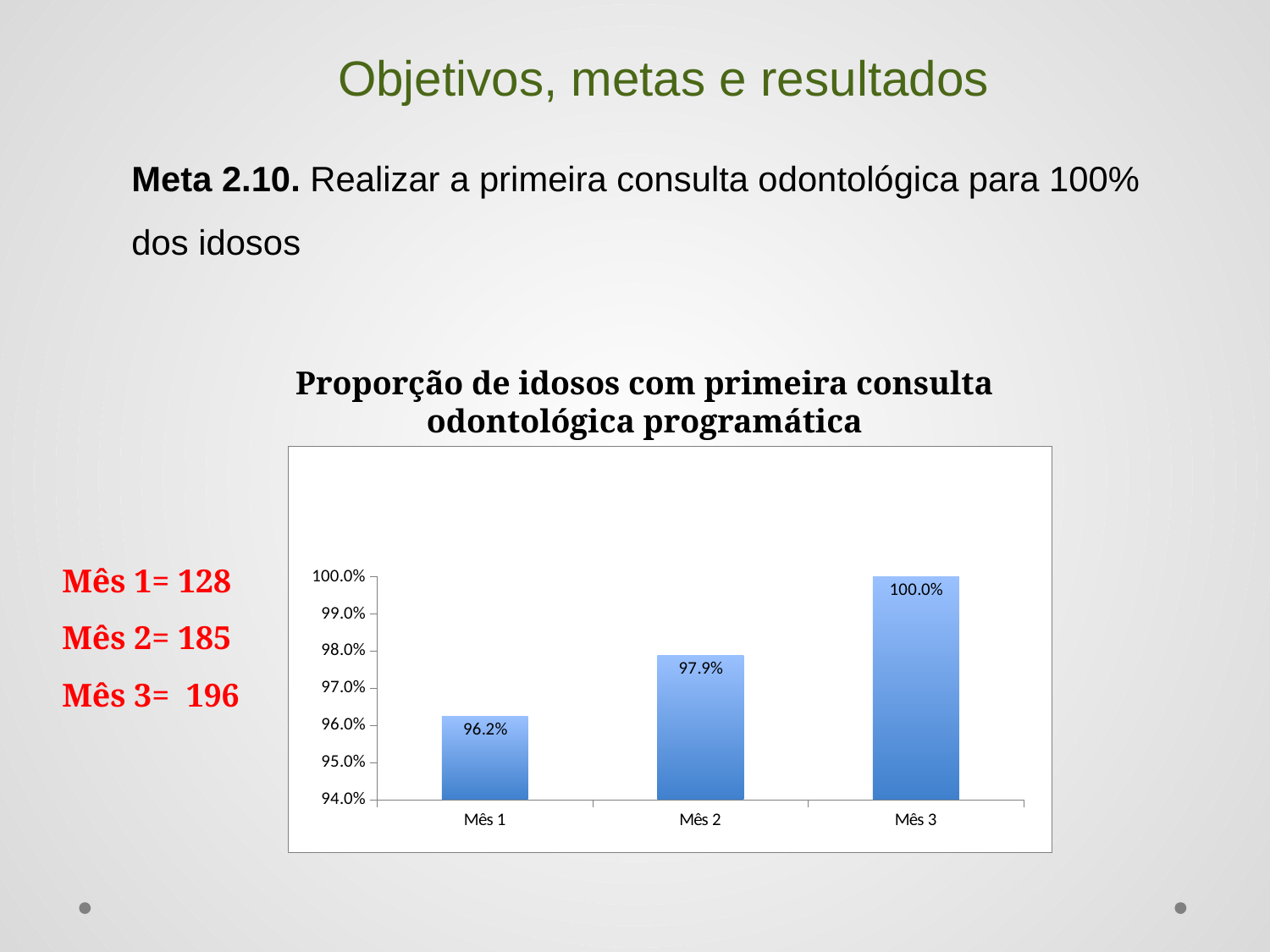
What kind of chart is shown on the slide? bar chart What is the value for Mês 3? 100.0% Which is larger, the value for Mês 2 or the value for Mês 1? Mês 2 Which month has the lowest proportion? Mês 1 What is the difference between the values for Mês 2 and Mês 1? 1.7% Is the value for Mês 2 greater or less than 97.0%? greater What is the value for Mês 2? 97.9% How many months are shown on the chart? 3 Which month has the highest proportion? Mês 3 Do the values rise or fall from Mês 1 to Mês 3? rise What is the value for Mês 1? 96.2% What is the difference between the values for Mês 3 and Mês 1? 3.8%